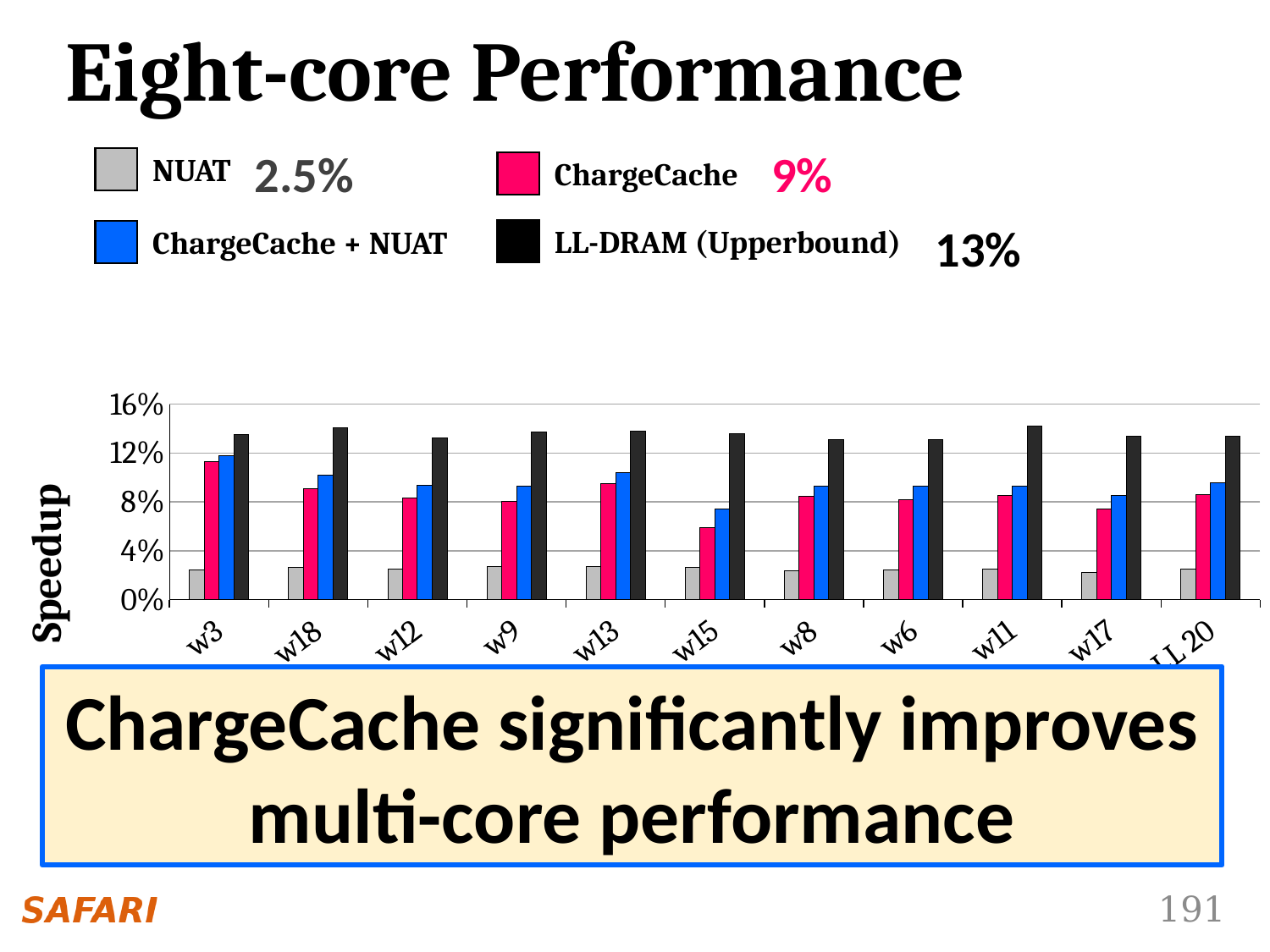
Is the ChargeCache speedup for w15 greater or less than 8%? less Which workload has the lowest ChargeCache speedup? w15 How many workload groups (categories) are plotted along the x axis? 11 What kind of chart is shown on the slide? bar chart Which workload has the highest ChargeCache speedup? w3 How many series does the legend list? 4 Is the ChargeCache speedup for w3 greater or less than 8%? greater For w15, which is larger: the ChargeCache speedup or the ChargeCache + NUAT speedup? ChargeCache + NUAT Is the LL-DRAM (Upperbound) speedup for w18 greater or less than 12%? greater For w3, which is larger: the ChargeCache speedup or the LL-DRAM (Upperbound) speedup? LL-DRAM (Upperbound) What is the label on the y axis of the chart? Speedup